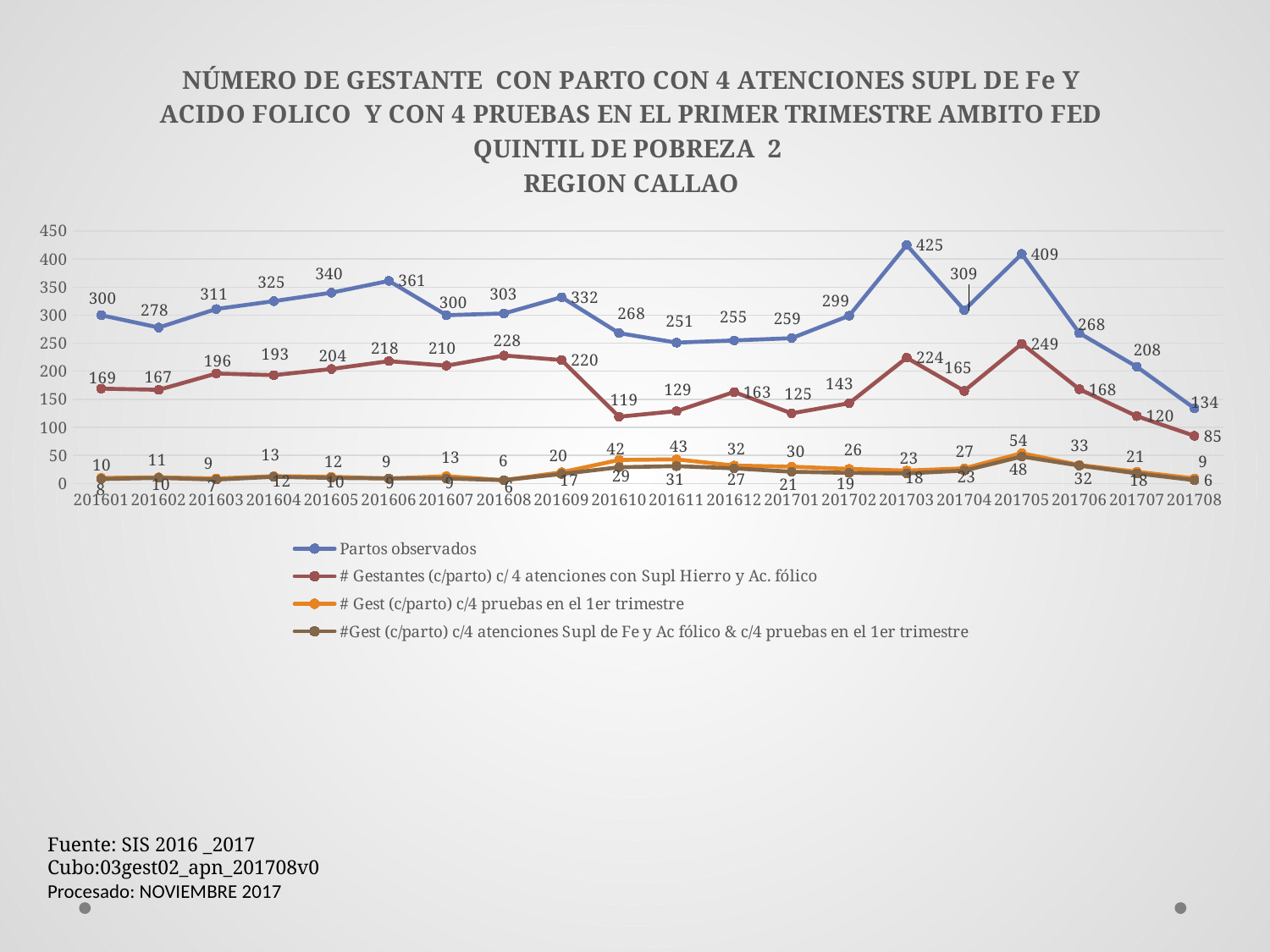
What is the value of Partos observados for 201703? 425 What is the value of # Gestantes (c/parto) c/ 4 atenciones con Supl Hierro y Ac. fólico for 201705? 249 Does Partos observados rise or fall from 201705 to 201708? fall What type of chart is shown on the slide? line chart What is the value of #Gest (c/parto) c/4 atenciones Supl de Fe y Ac fólico & c/4 pruebas en el 1er trimestre for 201705? 48 How many time periods are plotted along the x axis? 20 In which period is Partos observados lowest? 201708 How many series does the legend list? 4 What is the difference between Partos observados in 201703 and in 201705? 16 What is the value of # Gest (c/parto) c/4 pruebas en el 1er trimestre for 201611? 43 Which is larger: Partos observados in 201606 or in 201704? 201606 In which period is # Gest (c/parto) c/4 pruebas en el 1er trimestre highest? 201705